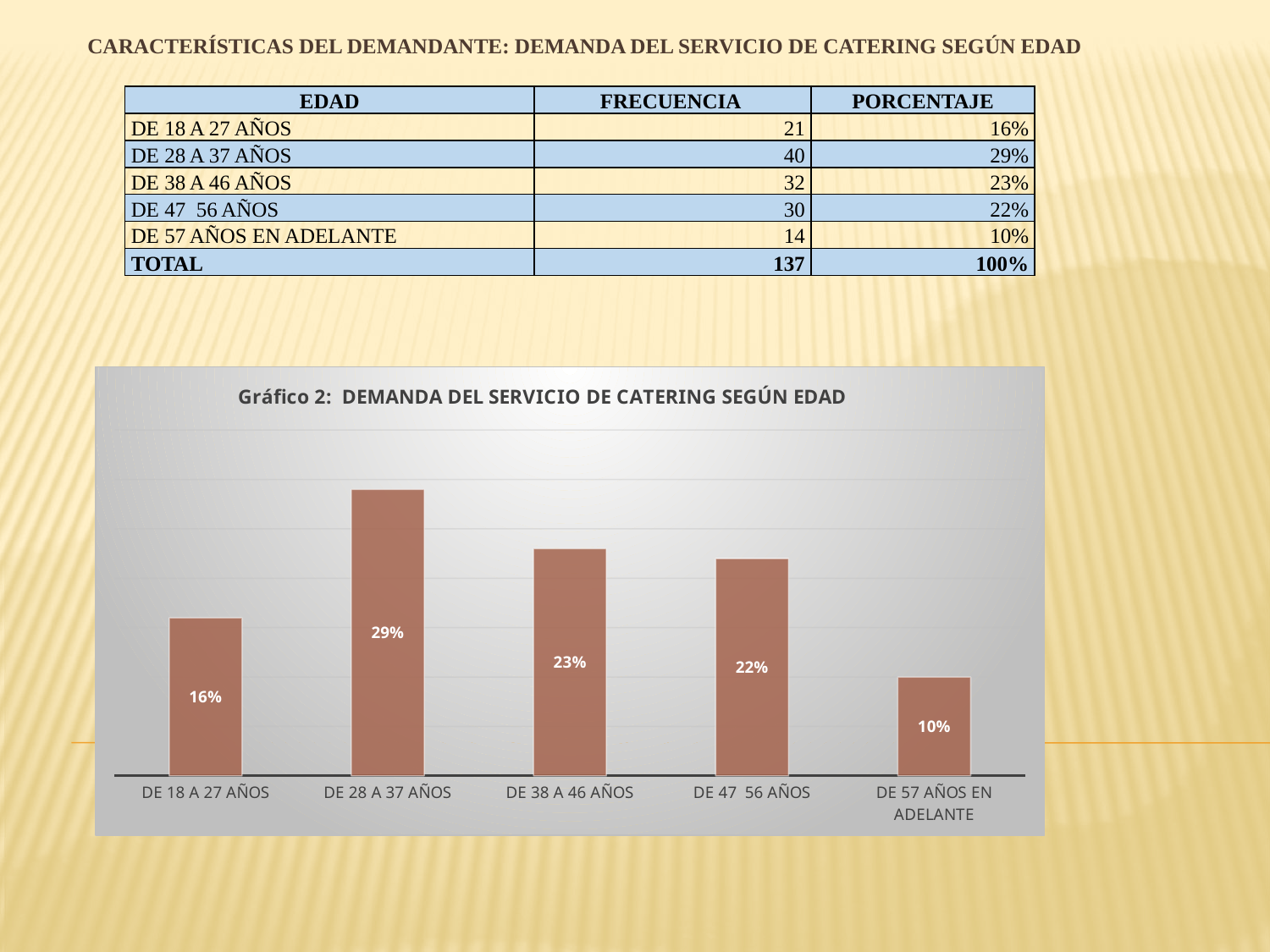
What is the value for DE 57 AÑOS EN ADELANTE in the chart? 10% What is the difference between the values for DE 28 A 37 AÑOS and DE 18 A 27 AÑOS? 13% What kind of chart is shown on the slide? bar chart How many age groups are shown in the chart? 5 What is the title of the chart? Gráfico 2: DEMANDA DEL SERVICIO DE CATERING SEGÚN EDAD What is the value for DE 28 A 37 AÑOS in the chart? 29% Which is larger, the value for DE 38 A 46 AÑOS or the value for DE 18 A 27 AÑOS? DE 38 A 46 AÑOS What is the value for DE 18 A 27 AÑOS in the chart? 16% Do the values rise or fall from DE 28 A 37 AÑOS to DE 57 AÑOS EN ADELANTE? fall Which age group has the highest value in the chart? DE 28 A 37 AÑOS Which age group has the lowest value in the chart? DE 57 AÑOS EN ADELANTE What is the difference between the values for DE 38 A 46 AÑOS and DE 57 AÑOS EN ADELANTE? 13%